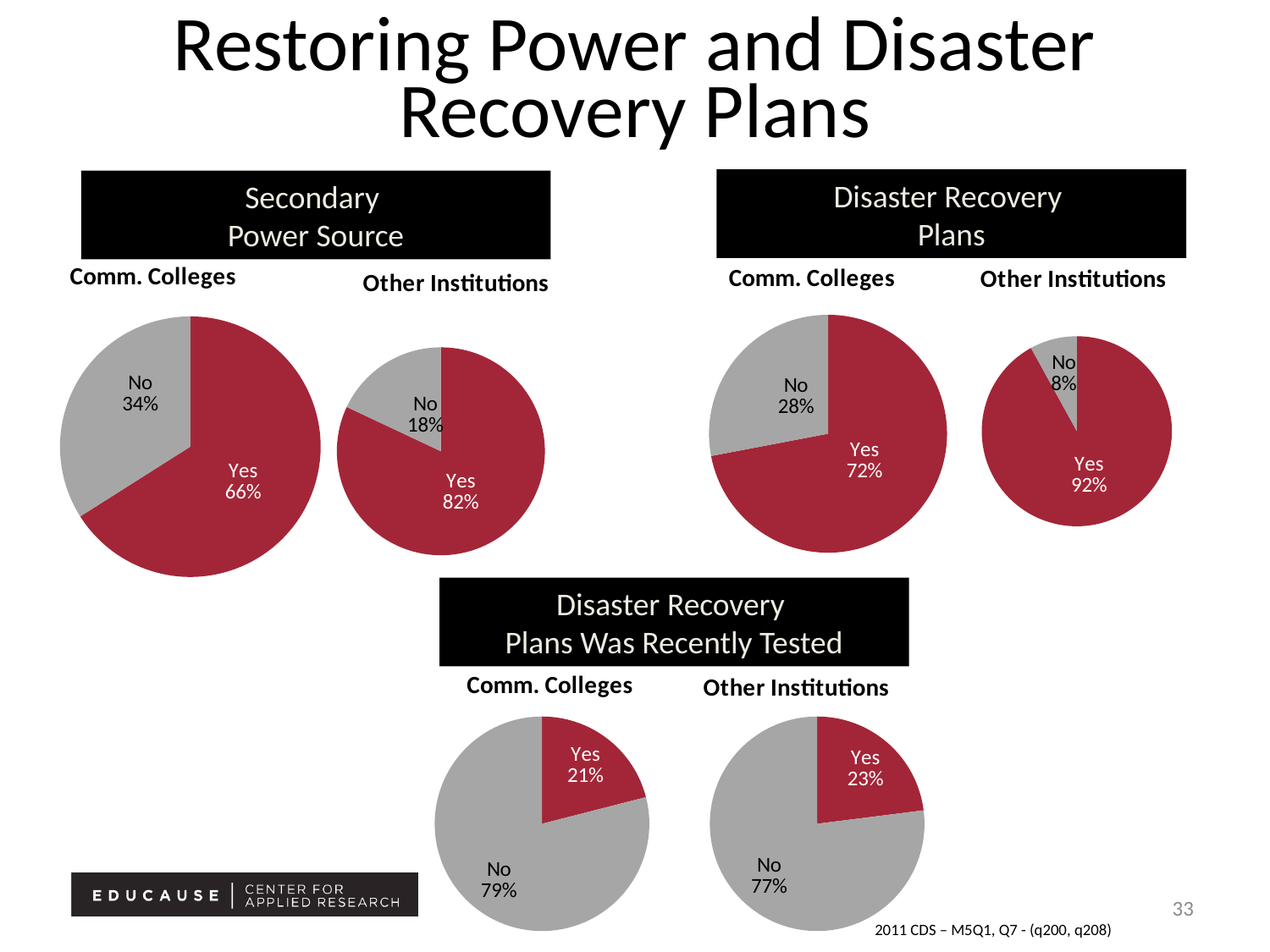
In the Disaster Recovery Plans chart for Comm. Colleges, what percentage answered No? 28% In the Disaster Recovery Plans Was Recently Tested chart for Comm. Colleges, what percentage answered Yes? 21% What is the difference between the Yes percentages for Other Institutions and Comm. Colleges in the Secondary Power Source charts? 16% What type of chart is used for the Secondary Power Source data for Comm. Colleges? Pie chart What colour represents the Yes slice in the pie charts on the slide? Red In the Disaster Recovery Plans Was Recently Tested chart for Comm. Colleges, which response is the largest slice? No In the Secondary Power Source chart for Comm. Colleges, what percentage answered Yes? 66% In the Disaster Recovery Plans chart for Other Institutions, which slice is larger, Yes or No? Yes In the Disaster Recovery Plans chart for Other Institutions, what percentage answered Yes? 92% How many slices does the Disaster Recovery Plans pie chart for Comm. Colleges have? 2 In the Disaster Recovery Plans Was Recently Tested chart for Other Institutions, what percentage answered No? 77% In the Secondary Power Source chart for Other Institutions, what percentage answered No? 18%